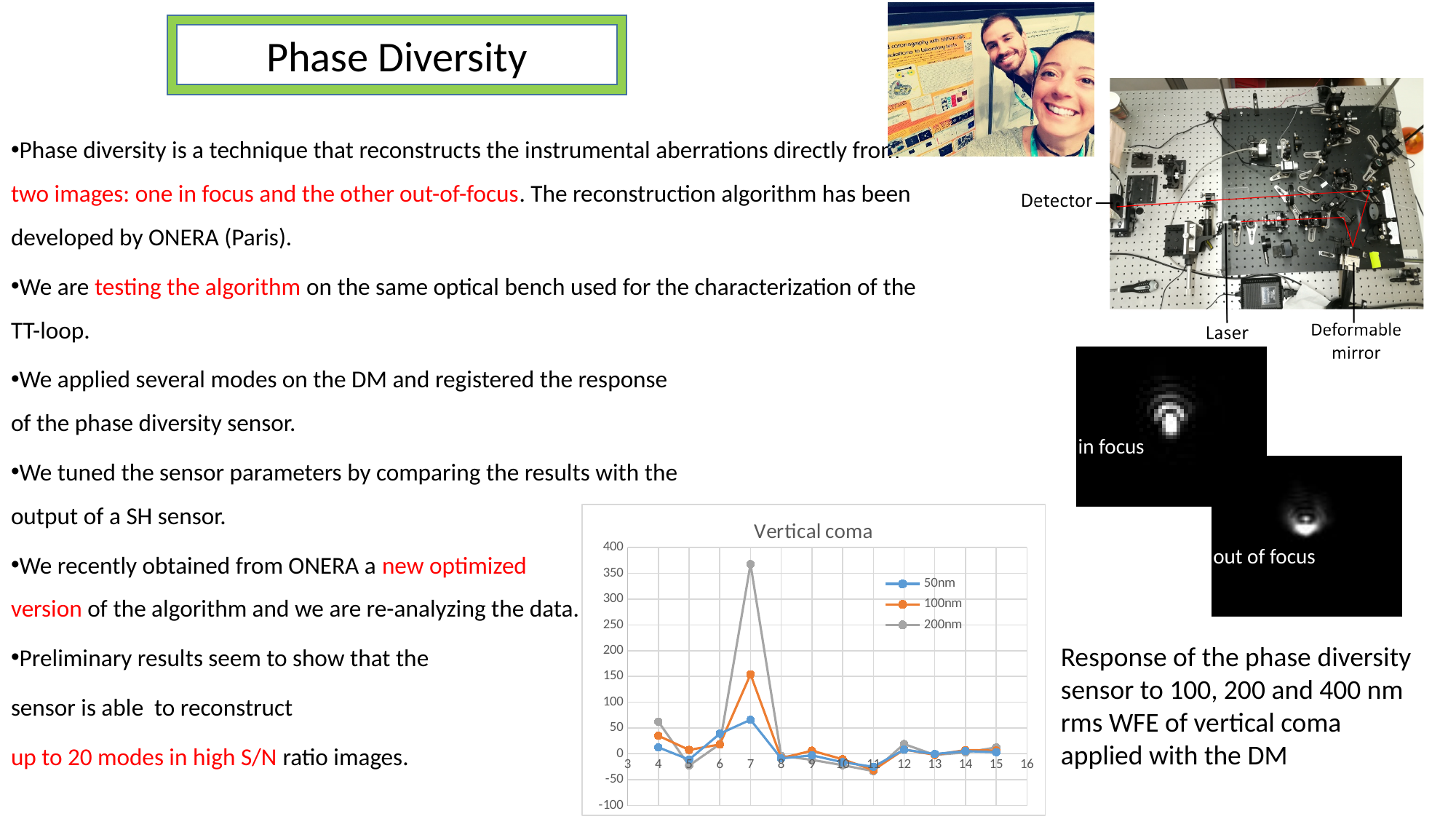
At x = 7, is the value of the 100nm series greater or less than 100? greater At x = 7, is the value of the 200nm series greater or less than 300? greater At x = 4, is the value of the 200nm series greater or less than 100? less What is the maximum value shown on the chart's vertical axis? 400 How many series does the chart legend list? 3 At x = 7, which series has the larger value, 50nm or 200nm? 200nm At which x value does the 200nm series reach its highest point? 7 What kind of chart is shown on the slide? line chart Which series reaches the highest value on the chart? 200nm What is the title of the chart? Vertical coma What are the series names listed in the chart legend? 50nm, 100nm, 200nm